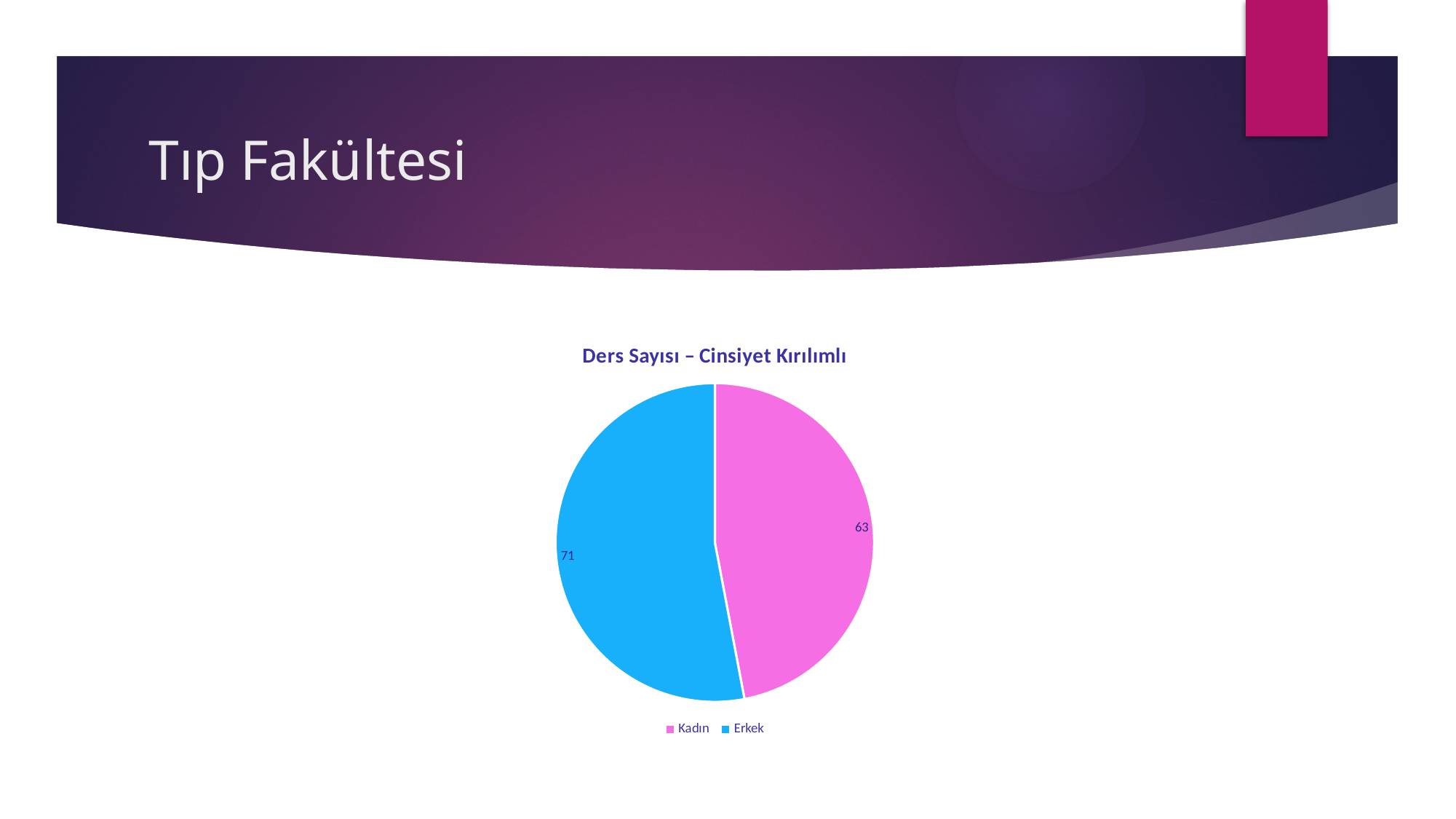
Which category has the smaller slice in the pie chart? Kadın What is the title of the chart? Ders Sayısı – Cinsiyet Kırılımlı Which category has the larger slice in the pie chart? Erkek Which colour represents Erkek in the pie chart? blue What is the value for Kadın in the pie chart? 63 What kind of chart is shown on the slide? pie chart Is the value for Erkek larger or smaller than the value for Kadın? larger What is the total of the two slices in the pie chart? 134 How many slices does the pie chart have? 2 How many entries does the legend list? 2 What is the difference between the Erkek and Kadın values? 8 What is the value for Erkek in the pie chart? 71